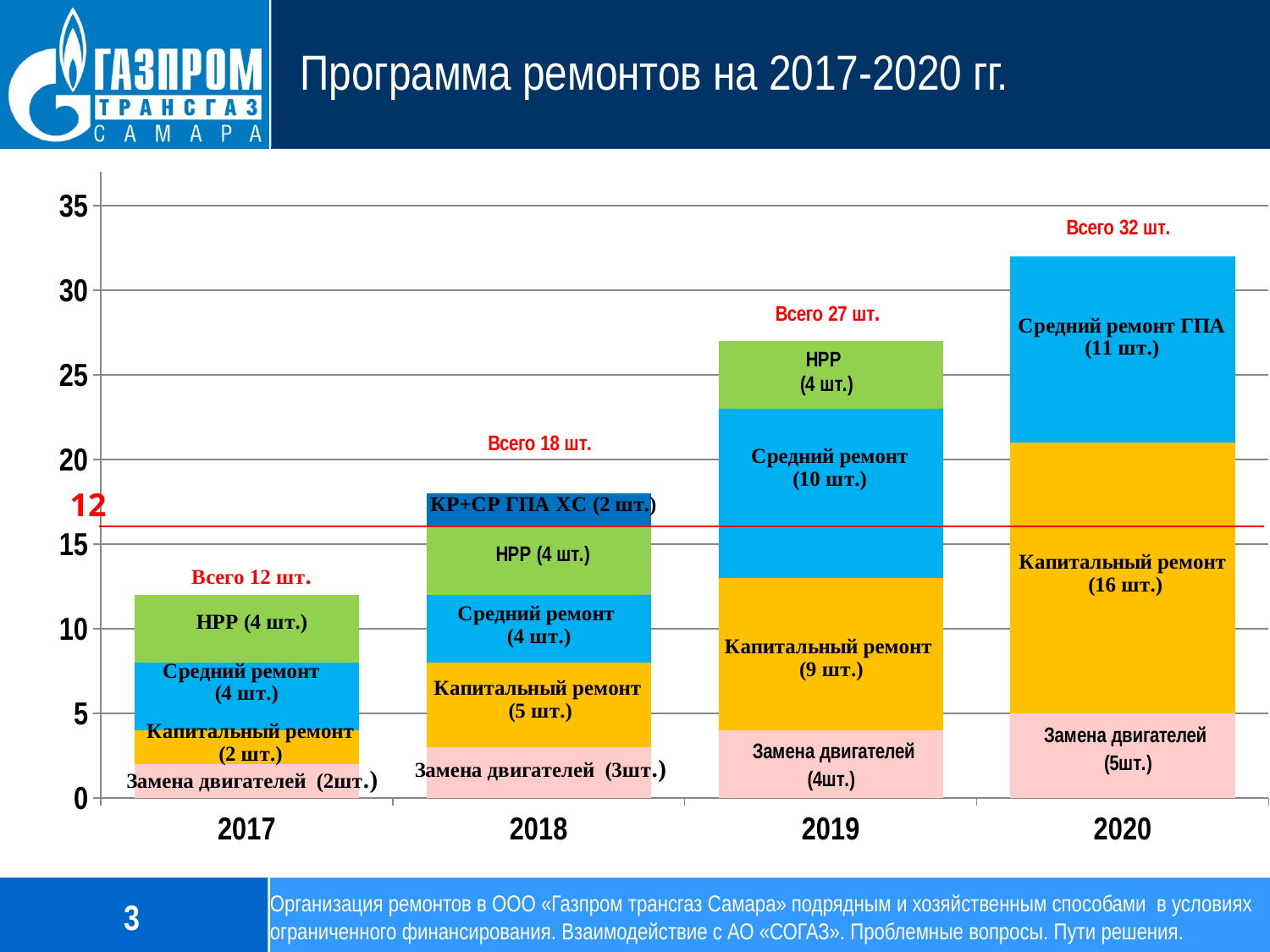
How many Средний ремонт ГПА repairs are shown for 2020? 11 шт. How many years (categories) are shown on the x axis of the chart? 4 What is the difference between the total repairs in 2020 and in 2017? 20 Do the total repairs rise or fall from 2017 to 2020? rise Which year has the highest total number of repairs? 2020 How many Капитальный ремонт repairs are shown for 2019? 9 шт. What is the total number of repairs (Всего) shown for 2020? 32 шт. Which is larger: Капитальный ремонт in 2020 or Капитальный ремонт in 2019? Капитальный ремонт in 2020 What kind of chart is shown on the slide? stacked bar chart What is the title of the slide containing the chart? Программа ремонтов на 2017-2020 гг. How many Замена двигателей are shown for 2018? 3 шт. Which year has the lowest total number of repairs? 2017